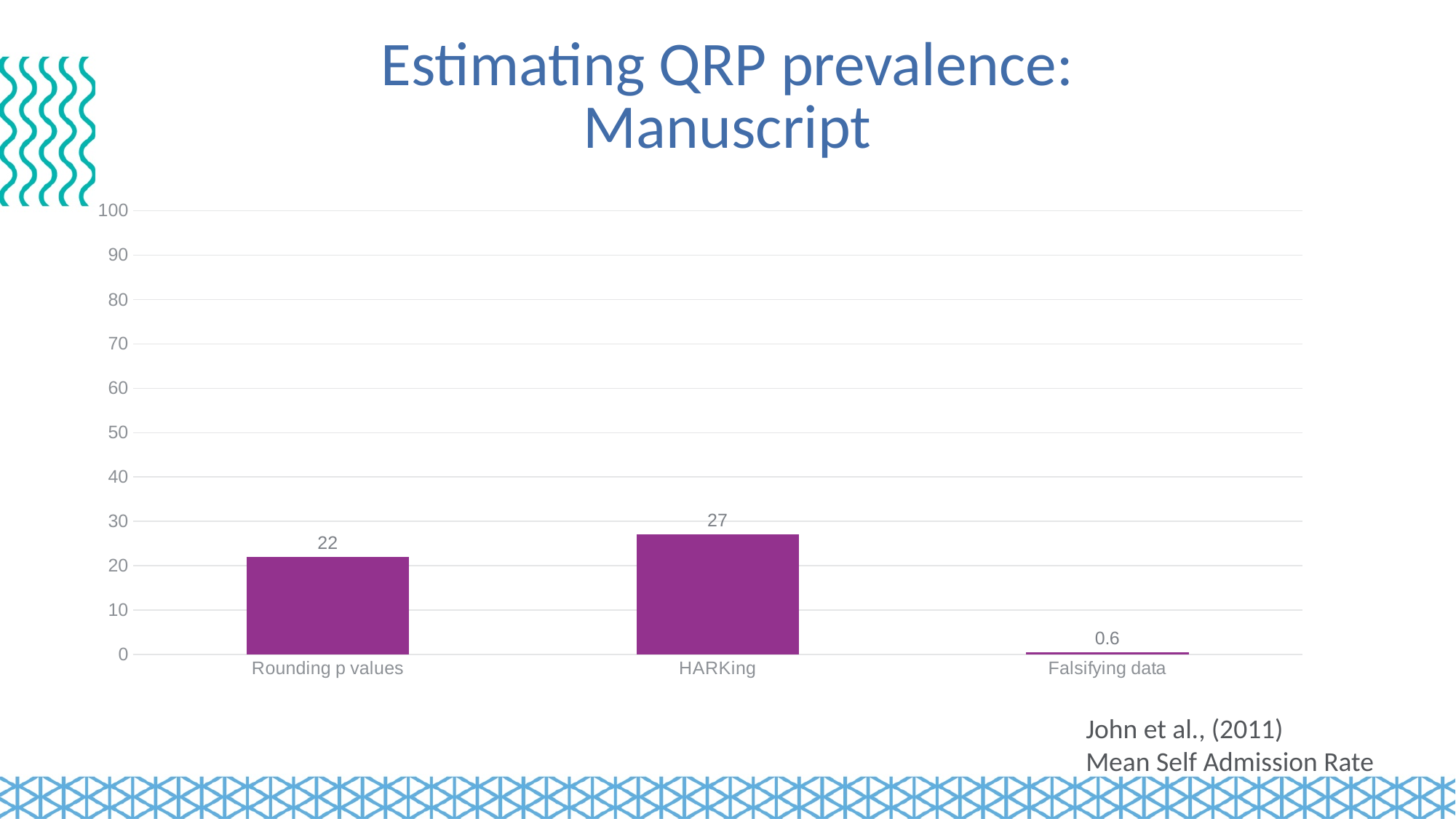
How many categories are shown on the x axis? 3 Is the value for HARKing greater or less than 30? less What is the difference between the values for HARKing and Rounding p values? 5 Which is larger, the value for Rounding p values or the value for HARKing? HARKing What is the value for Rounding p values? 22 Which category has the lowest value? Falsifying data What colour are the bars in the chart? purple What is the maximum value shown on the y axis? 100 What kind of chart is shown on the slide? bar chart Which category has the highest value? HARKing What is the value for HARKing? 27 What is the value for Falsifying data? 0.6